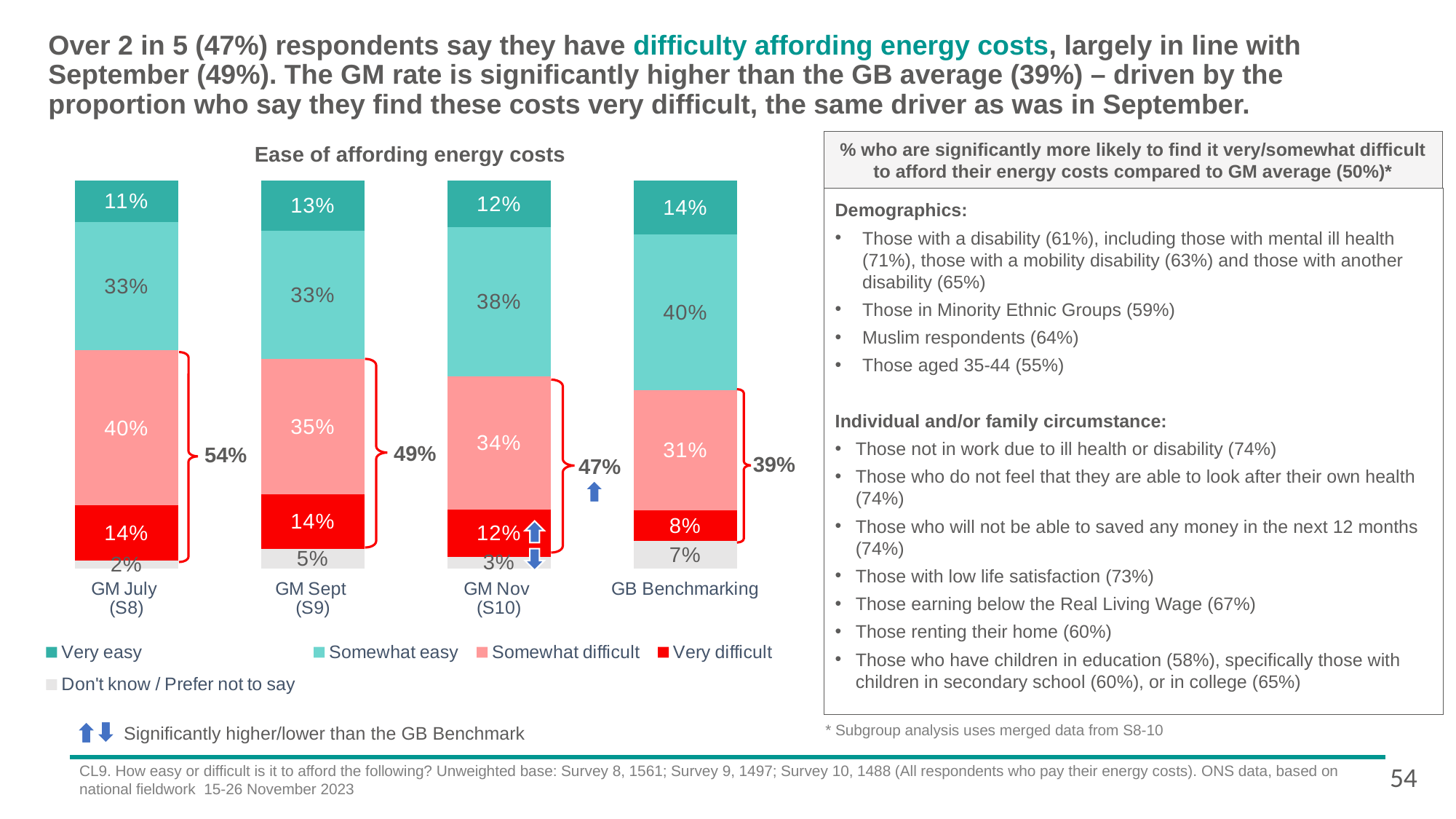
Which bar has the highest 'Somewhat difficult' value? GM July (S8) What is the difference between the 'Very difficult' values for GM Sept (S9) and GB Benchmarking? 6% Which bar has the lowest 'Very difficult' value? GB Benchmarking What percentage of GM Nov (S10) respondents said affording energy costs was very difficult? 12% How many series does the legend list? 5 How many bars (survey waves/benchmarks) are shown in the chart? 4 What type of chart is 'Ease of affording energy costs'? Stacked bar chart What is the 'Somewhat easy' value for GB Benchmarking? 40% What colour represents 'Very difficult' in the chart? Red Which is larger: the 'Somewhat easy' value for GM Nov (S10) or for GM July (S8)? GM Nov (S10) What is the 'Don't know / Prefer not to say' value for GM Sept (S9)? 5% What is the combined very/somewhat difficult percentage shown by the bracket for GM Nov (S10)? 47%